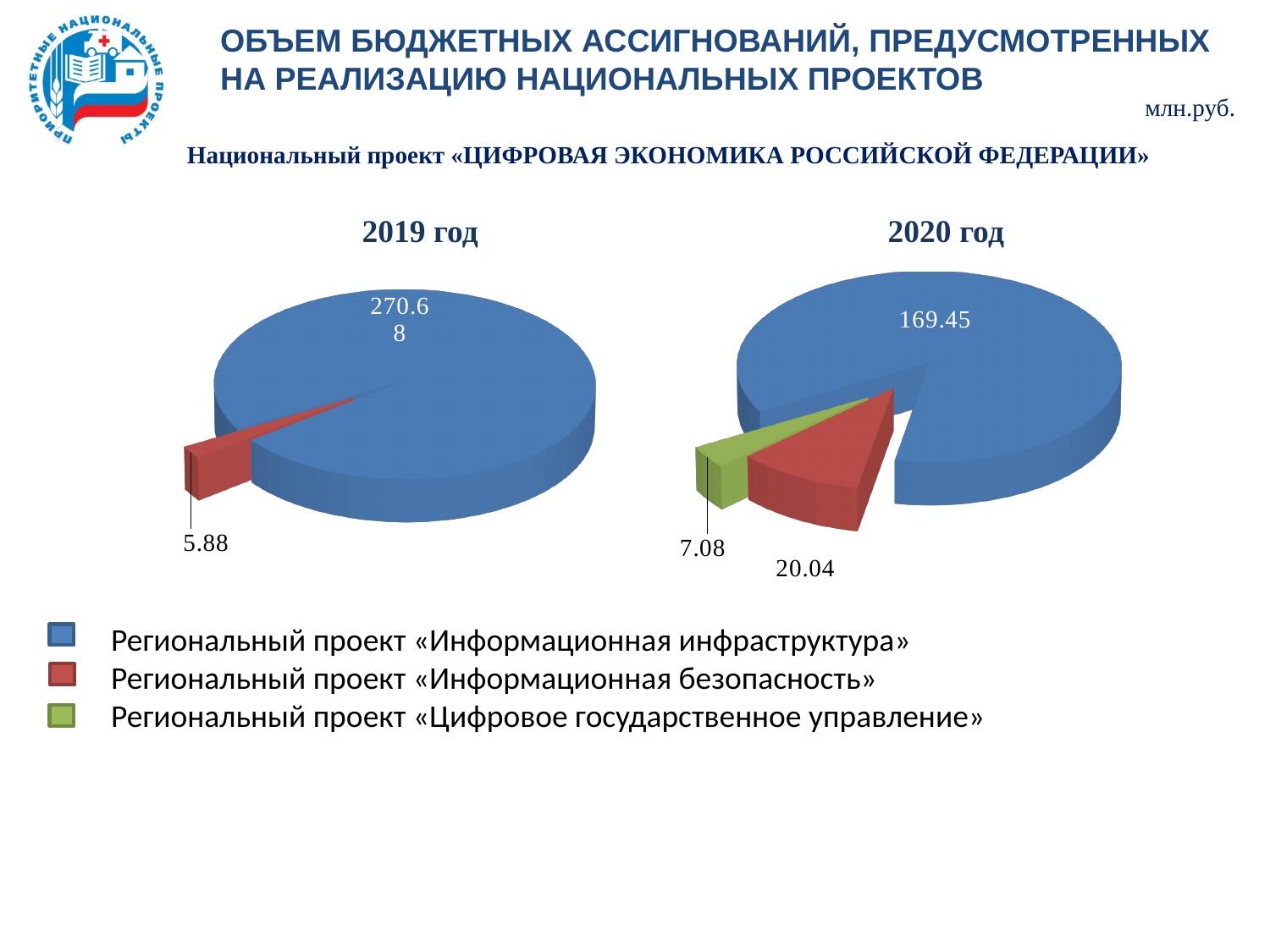
In the 2020 год chart, which regional project has the smallest slice? Региональный проект «Цифровое государственное управление» In the 2019 год chart, what is the value for Региональный проект «Информационная безопасность»? 5.88 Is the value for «Информационная инфраструктура» larger in the 2019 год chart or the 2020 год chart? 2019 год What kind of chart is the 2019 год chart? Pie chart In the 2020 год chart, which regional project has the largest slice? Региональный проект «Информационная инфраструктура» What is the total of all slices in the 2020 год chart? 196.57 How many slices does the 2020 год chart have? 3 In the 2020 год chart, what is the value for Региональный проект «Информационная безопасность»? 20.04 In the 2020 год chart, what is the value for Региональный проект «Цифровое государственное управление»? 7.08 In the 2020 год chart, what is the difference between the values for «Информационная безопасность» and «Цифровое государственное управление»? 12.96 In the 2019 год chart, what is the difference between the values for «Информационная инфраструктура» and «Информационная безопасность»? 264.8 In the 2019 год chart, what is the value for Региональный проект «Информационная инфраструктура»? 270.68